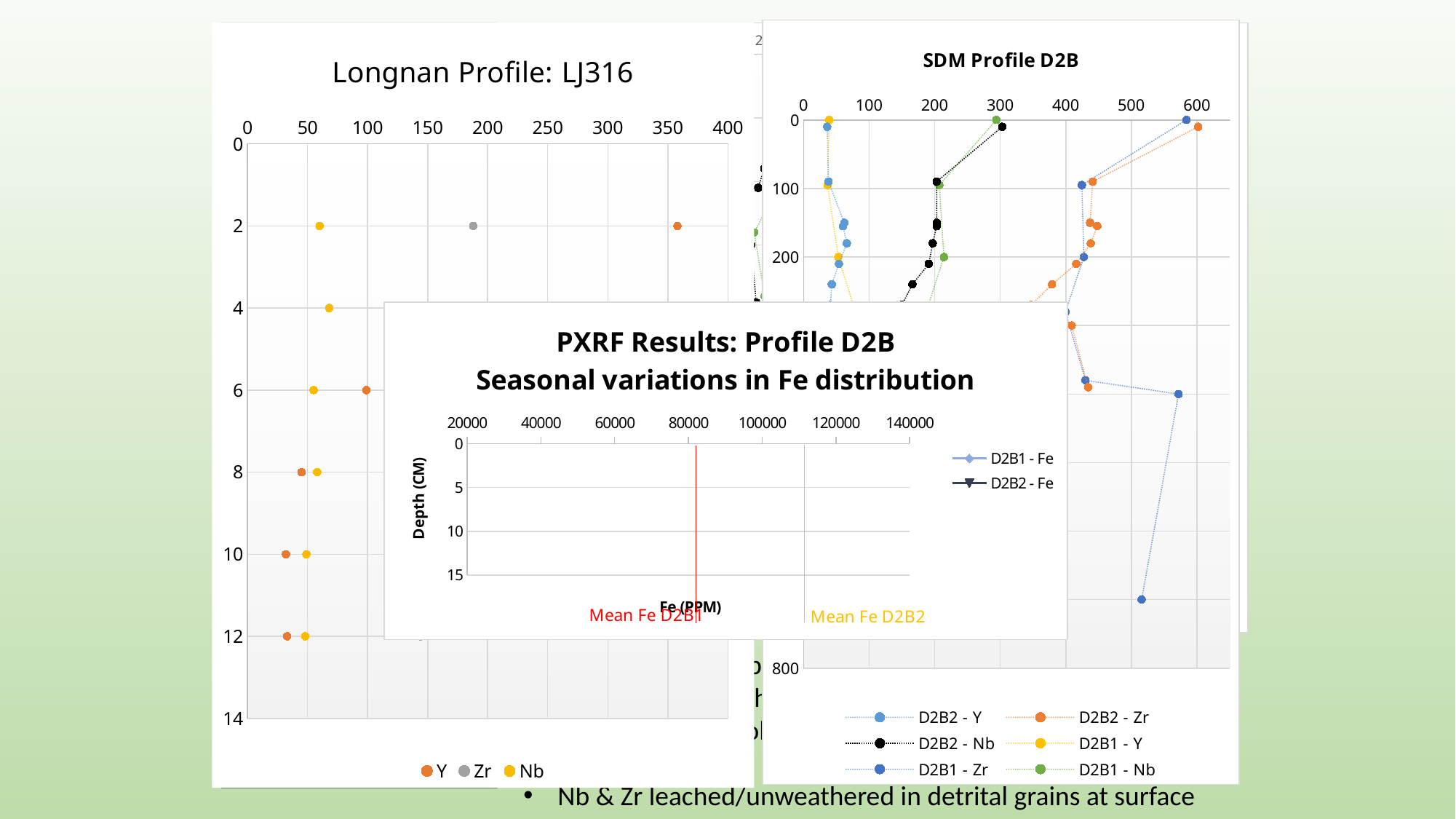
In the Longnan Profile: LJ316 chart, do the Y values rise or fall as depth increases from 2 to 12? fall In the Longnan Profile: LJ316 chart, which series has the highest value at depth 2? Y In the Longnan Profile: LJ316 chart, is the Nb value at depth 2 greater or less than 100? less In the Longnan Profile: LJ316 chart, which is larger at depth 6, Y or Nb? Y In the Longnan Profile: LJ316 chart, is the Zr value at depth 2 greater or less than 150? greater In the Longnan Profile: LJ316 chart, is the Y value at depth 2 greater or less than 300? greater How many series does the legend of the SDM Profile D2B chart list? 6 What kind of chart is the Longnan Profile: LJ316 chart? scatter chart How many series does the legend of the PXRF Results: Profile D2B chart list? 2 How many series does the legend of the Longnan Profile: LJ316 chart list? 3 What is the x-axis label of the PXRF Results: Profile D2B chart? Fe (PPM)